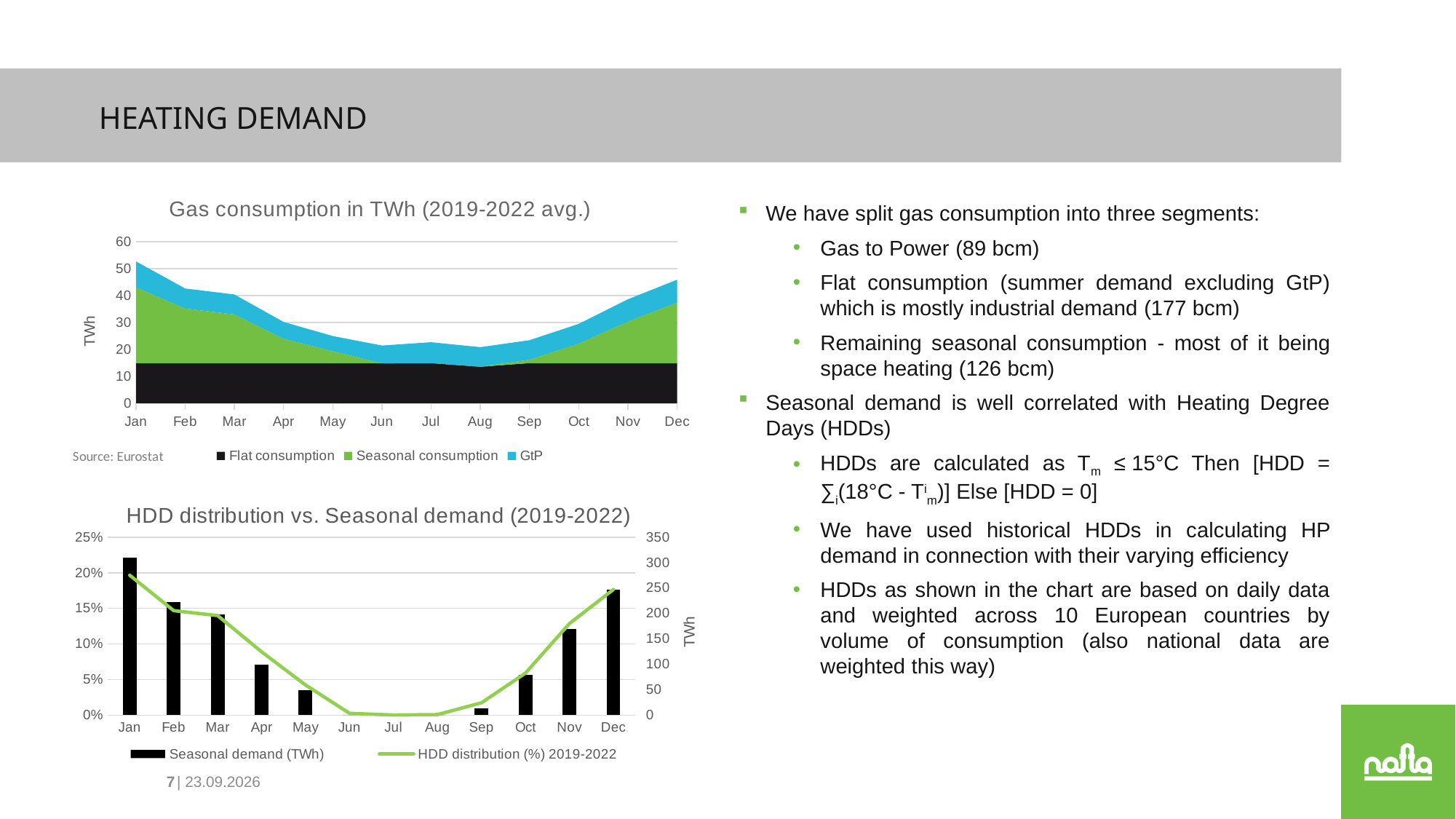
In the top chart 'Gas consumption in TWh (2019-2022 avg.)', which month has the highest total gas consumption? Jan In the bottom chart 'HDD distribution vs. Seasonal demand (2019-2022)', is the Seasonal demand bar for Apr greater or less than 10%? less In the bottom chart 'HDD distribution vs. Seasonal demand (2019-2022)', which is larger, the Seasonal demand bar for Feb or for Nov? Feb In the top chart 'Gas consumption in TWh (2019-2022 avg.)', is the total gas consumption in Aug greater or less than 30 TWh? less In the top chart 'Gas consumption in TWh (2019-2022 avg.)', which series is shown in black? Flat consumption In the top chart 'Gas consumption in TWh (2019-2022 avg.)', is the total gas consumption in Dec greater or less than 40 TWh? greater How many series does the legend of the bottom chart 'HDD distribution vs. Seasonal demand (2019-2022)' list? 2 In the top chart 'Gas consumption in TWh (2019-2022 avg.)', does total gas consumption rise or fall from Jan to Jun? Fall What kind of chart is the top chart, 'Gas consumption in TWh (2019-2022 avg.)'? Stacked area chart How many series does the legend of the top chart 'Gas consumption in TWh (2019-2022 avg.)' list? 3 In the bottom chart 'HDD distribution vs. Seasonal demand (2019-2022)', which month has the highest Seasonal demand bar? Jan How many months are shown on the x axis of the bottom chart 'HDD distribution vs. Seasonal demand (2019-2022)'? 12